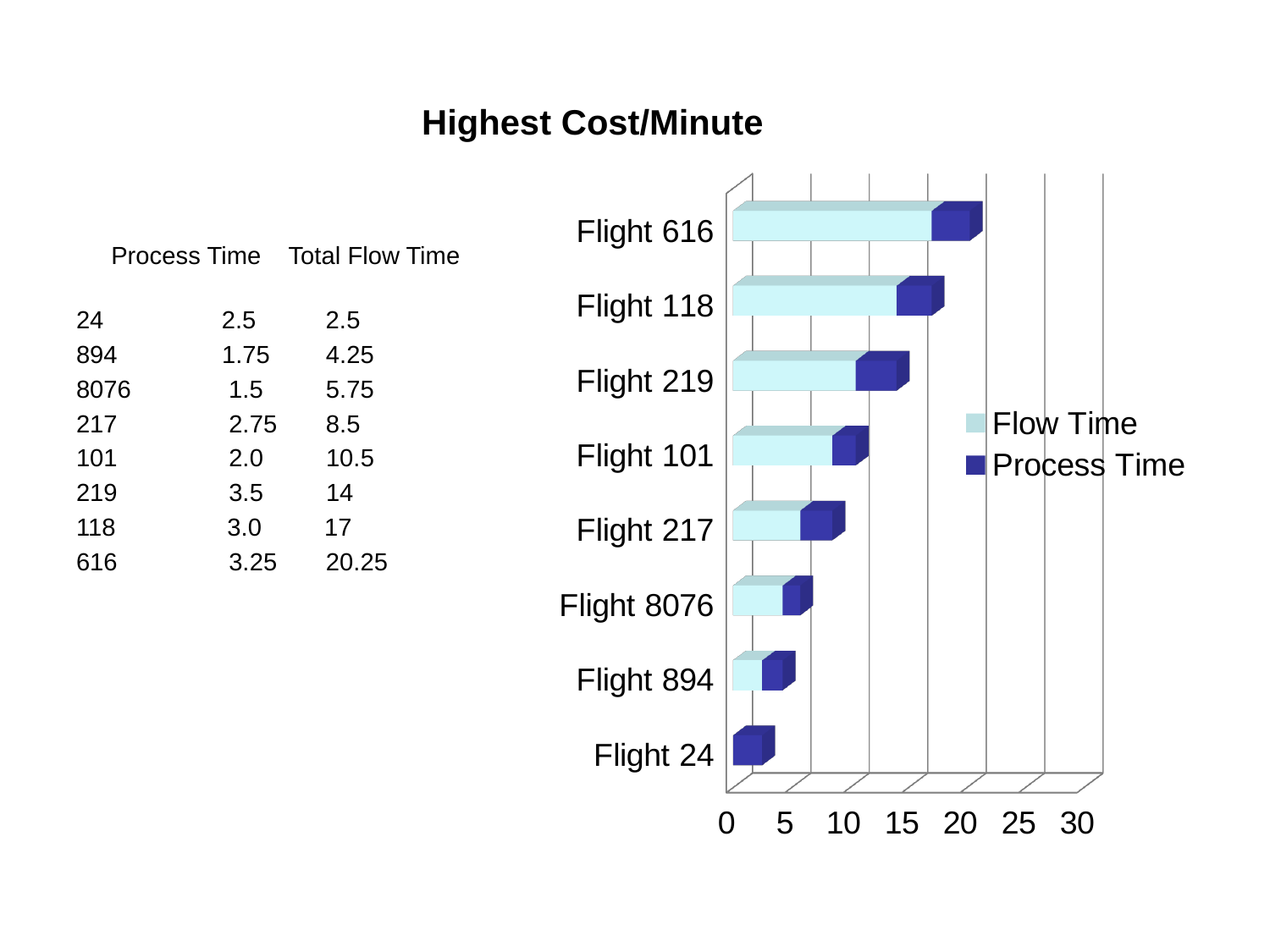
How many flights are plotted in the chart? 8 What is the title of the chart? Highest Cost/Minute Which flight has the shortest total bar in the chart? Flight 24 How many series does the chart legend list? 2 Which series is shown in dark blue in the chart legend? Process Time Which flight has the longest total bar in the chart? Flight 616 Which flight has the longer total bar, Flight 118 or Flight 219? Flight 118 Is the total bar length for Flight 101 greater or less than 5? greater Is the total bar length for Flight 217 greater or less than 10? less What kind of chart is shown on the slide? bar chart Is the total bar length for Flight 616 greater or less than 15? greater